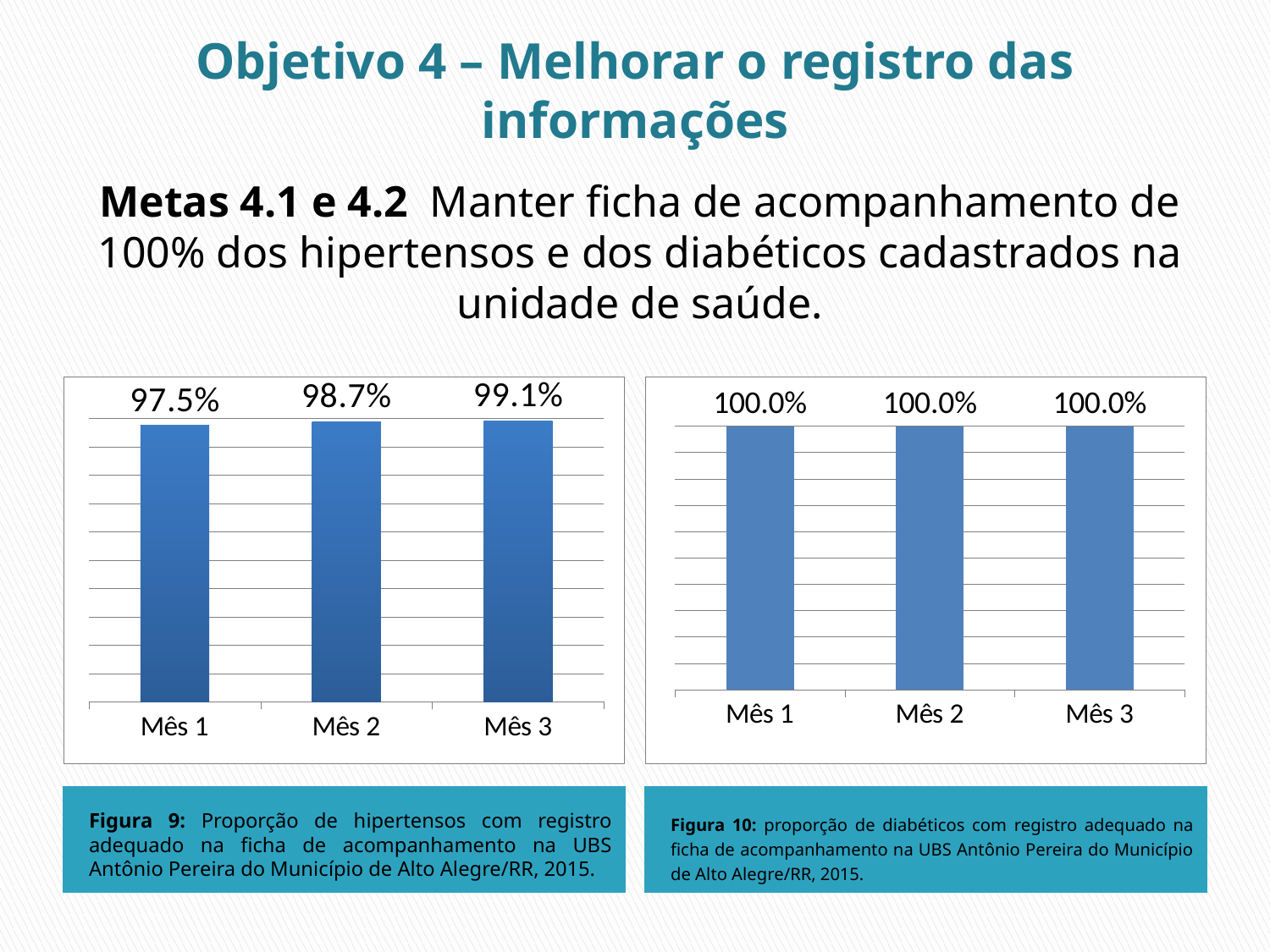
How many bars are plotted in the right chart (Figura 10)? 3 In the left chart (Figura 9), what is the difference between the values for Mês 3 and Mês 1? 1.6% In the left chart (Figura 9), what is the value for Mês 3? 99.1% In the right chart (Figura 10), what is the value for Mês 2? 100.0% In the left chart (Figura 9), which month has the lowest value? Mês 1 In the right chart (Figura 10), do the values change from Mês 1 to Mês 3? No, they stay at 100.0% In the left chart (Figura 9), do the values rise or fall from Mês 1 to Mês 3? Rise What kind of chart is the left chart (Figura 9)? Bar chart In the left chart (Figura 9), which month has the highest value? Mês 3 According to its caption, what does the right chart (Figura 10) show the proportion of? Diabéticos com registro adequado na ficha de acompanhamento In the left chart (Figura 9), which is larger, the value for Mês 2 or Mês 1? Mês 2 In the left chart (Figura 9), what is the value for Mês 1? 97.5%